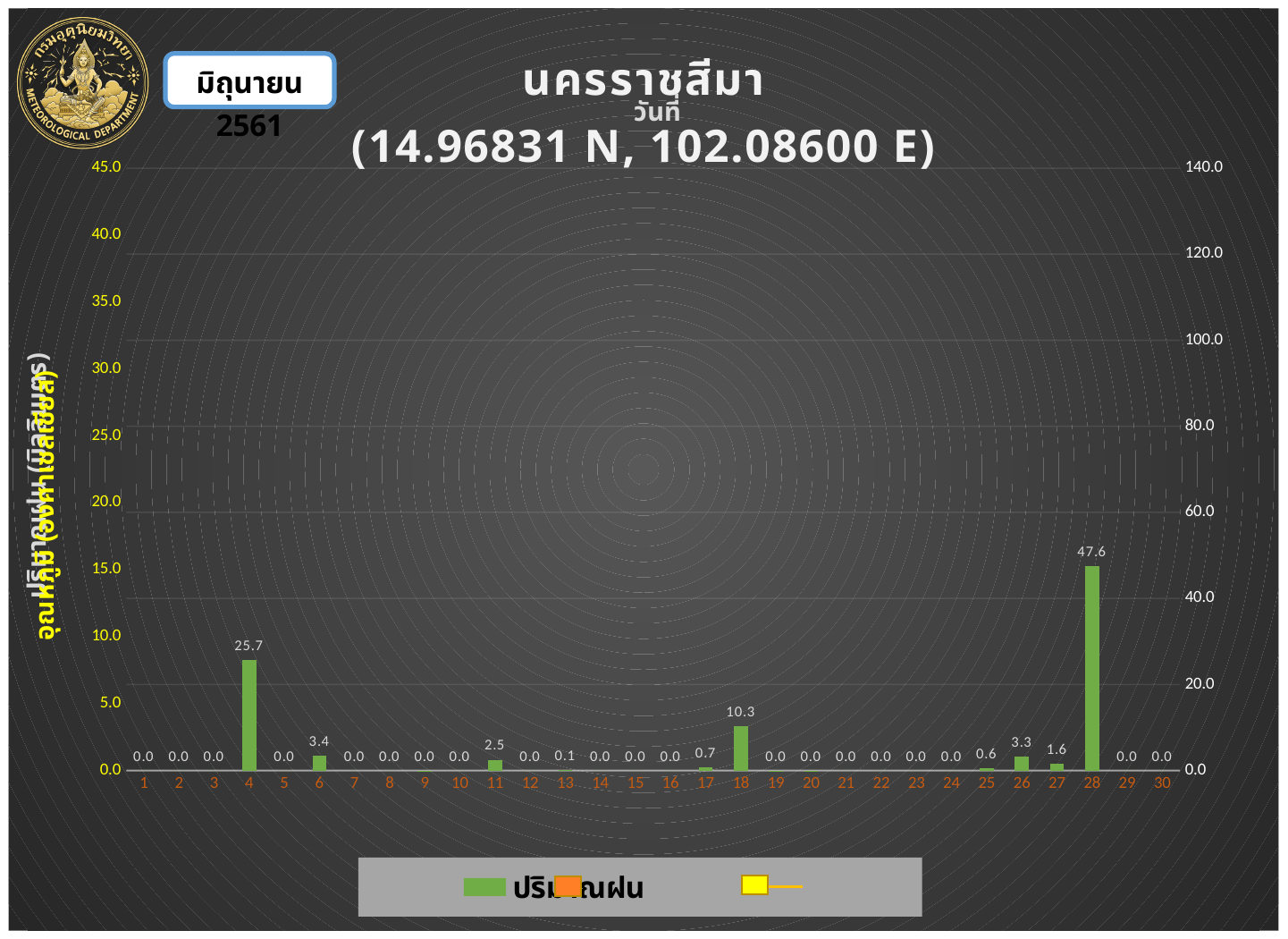
What is the difference between the rainfall values for day 28 and day 4? 21.9 What kind of chart is shown on the slide? bar chart Which has a larger rainfall value, day 6 or day 26? day 6 What is the rainfall value shown for day 13? 0.1 What is the difference between the rainfall values for day 26 and day 27? 1.7 What is the rainfall value shown for day 4? 25.7 What is the rainfall value shown for day 18? 10.3 Which day has the highest rainfall value? 28 What coordinates are given in the chart title? 14.96831 N, 102.08600 E What is the rainfall value shown for day 28? 47.6 How many days are shown on the x axis? 30 Which has a larger rainfall value, day 18 or day 11? day 18